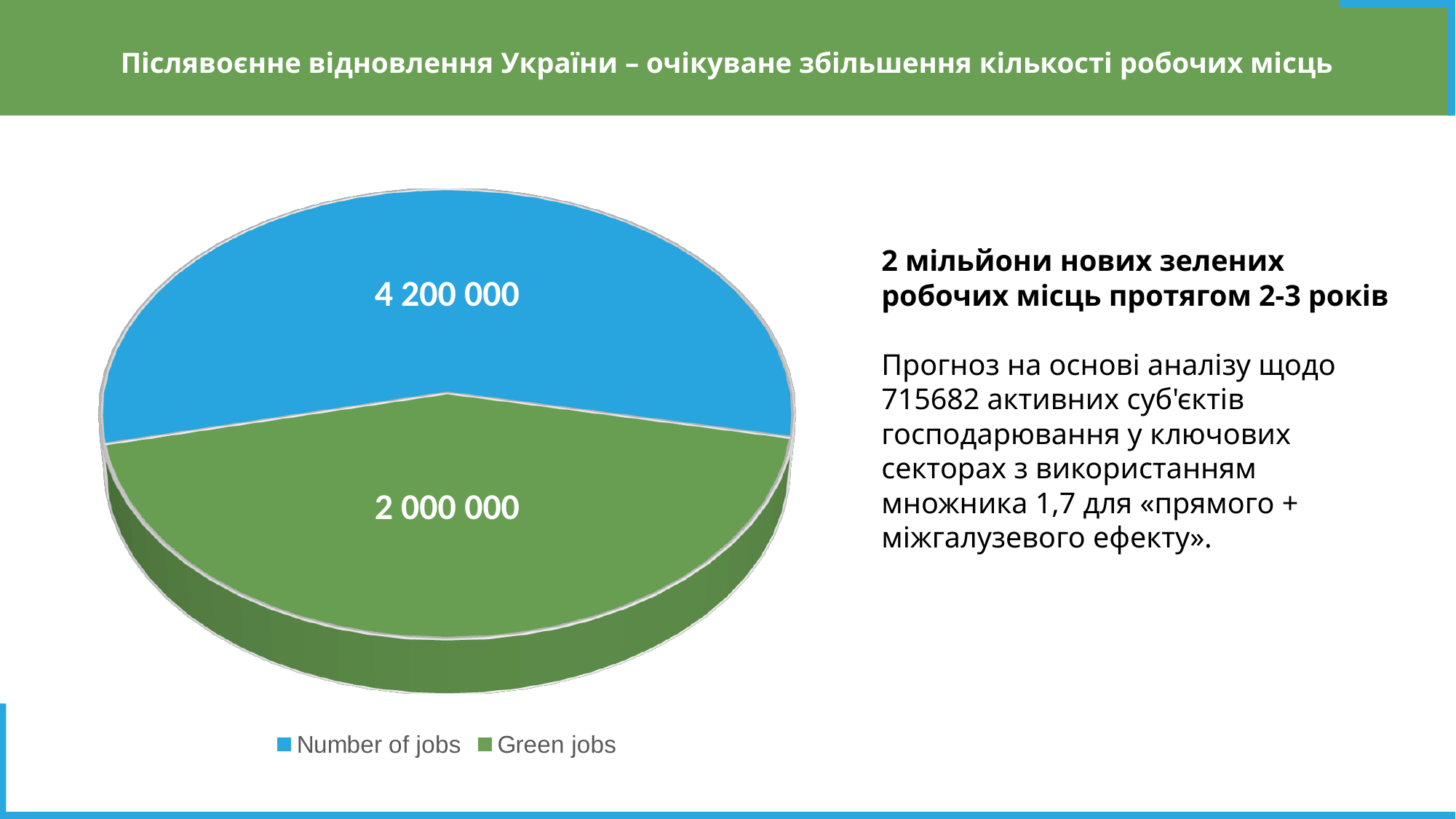
What kind of chart is shown on the slide? Pie chart What is the total of the two values shown in the pie chart? 6 200 000 What is the difference between the Number of jobs value and the Green jobs value in the pie chart? 2 200 000 How many entries does the legend of the pie chart list? 2 What colour is the Green jobs slice in the pie chart? Green What value is shown for the Number of jobs slice in the pie chart? 4 200 000 How many slices does the pie chart have? 2 Which slice of the pie chart is the largest? Number of jobs Which is larger in the pie chart: Number of jobs or Green jobs? Number of jobs What value is shown for the Green jobs slice in the pie chart? 2 000 000 Which slice of the pie chart is the smallest? Green jobs